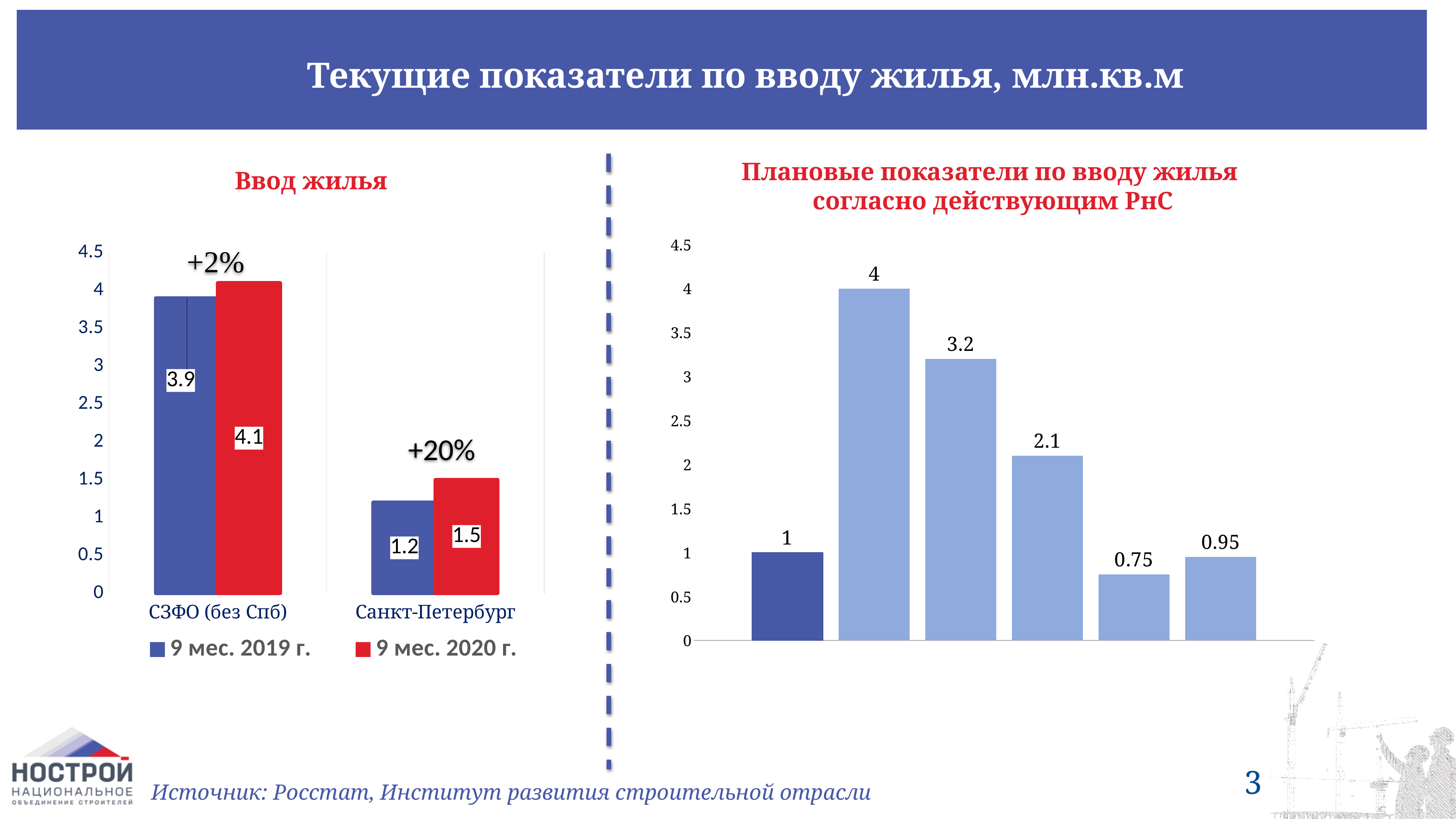
In the chart titled "Ввод жилья", how many categories are shown on the x axis? 2 In the chart titled "Ввод жилья", what is the value for Санкт-Петербург in the series "9 мес. 2020 г."? 1.5 In the chart on the right ("Плановые показатели по вводу жилья согласно действующим РнС"), how many bars are plotted? 6 In the chart titled "Ввод жилья", what is the difference between the 9 мес. 2020 г. and 9 мес. 2019 г. values for СЗФО (без Спб)? 0.2 In the chart on the right ("Плановые показатели по вводу жилья согласно действующим РнС"), what is the value of the lowest bar? 0.75 In the chart titled "Ввод жилья", which series has the larger value for Санкт-Петербург, 9 мес. 2019 г. or 9 мес. 2020 г.? 9 мес. 2020 г. In the chart on the right ("Плановые показатели по вводу жилья согласно действующим РнС"), what is the value of the highest bar? 4 What kind of chart is the chart titled "Ввод жилья"? bar chart In the chart titled "Ввод жилья", what is the value for СЗФО (без Спб) in the series "9 мес. 2019 г."? 3.9 In the chart on the right ("Плановые показатели по вводу жилья согласно действующим РнС"), what is the value of the leftmost bar? 1 In the chart titled "Ввод жилья", what percentage change is printed above the Санкт-Петербург bars? +20% In the chart titled "Ввод жилья", how many series does the legend list? 2